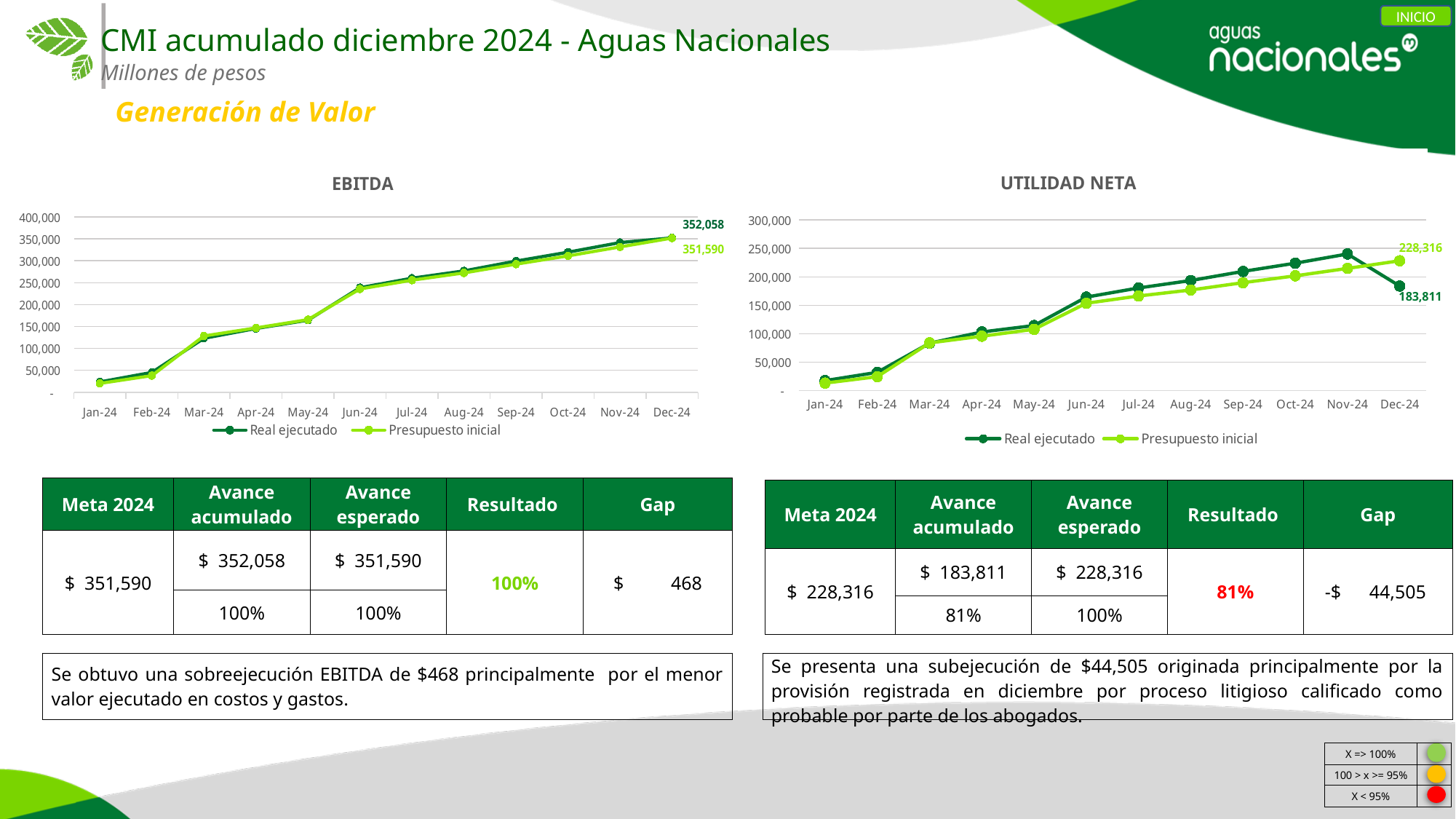
In the EBITDA chart, what is the value of Real ejecutado at Dec-24? 352,058 In the EBITDA chart, what is the value of Presupuesto inicial at Dec-24? 351,590 In the UTILIDAD NETA chart, is the value of Real ejecutado at Nov-24 greater or less than 200,000? greater In the UTILIDAD NETA chart, which series has the larger value at Dec-24, Real ejecutado or Presupuesto inicial? Presupuesto inicial In the UTILIDAD NETA chart, what is the difference between Presupuesto inicial and Real ejecutado at Dec-24? 44,505 In the EBITDA chart, is the value of Real ejecutado at Jan-24 greater or less than 50,000? less How many series does the legend of the EBITDA chart list? 2 In the UTILIDAD NETA chart, what is the value of Presupuesto inicial at Dec-24? 228,316 In the UTILIDAD NETA chart, what is the value of Real ejecutado at Dec-24? 183,811 What kind of chart is the EBITDA chart? Line chart In the EBITDA chart, what is the difference between Real ejecutado and Presupuesto inicial at Dec-24? 468 How many months are shown on the x axis of the EBITDA chart? 12